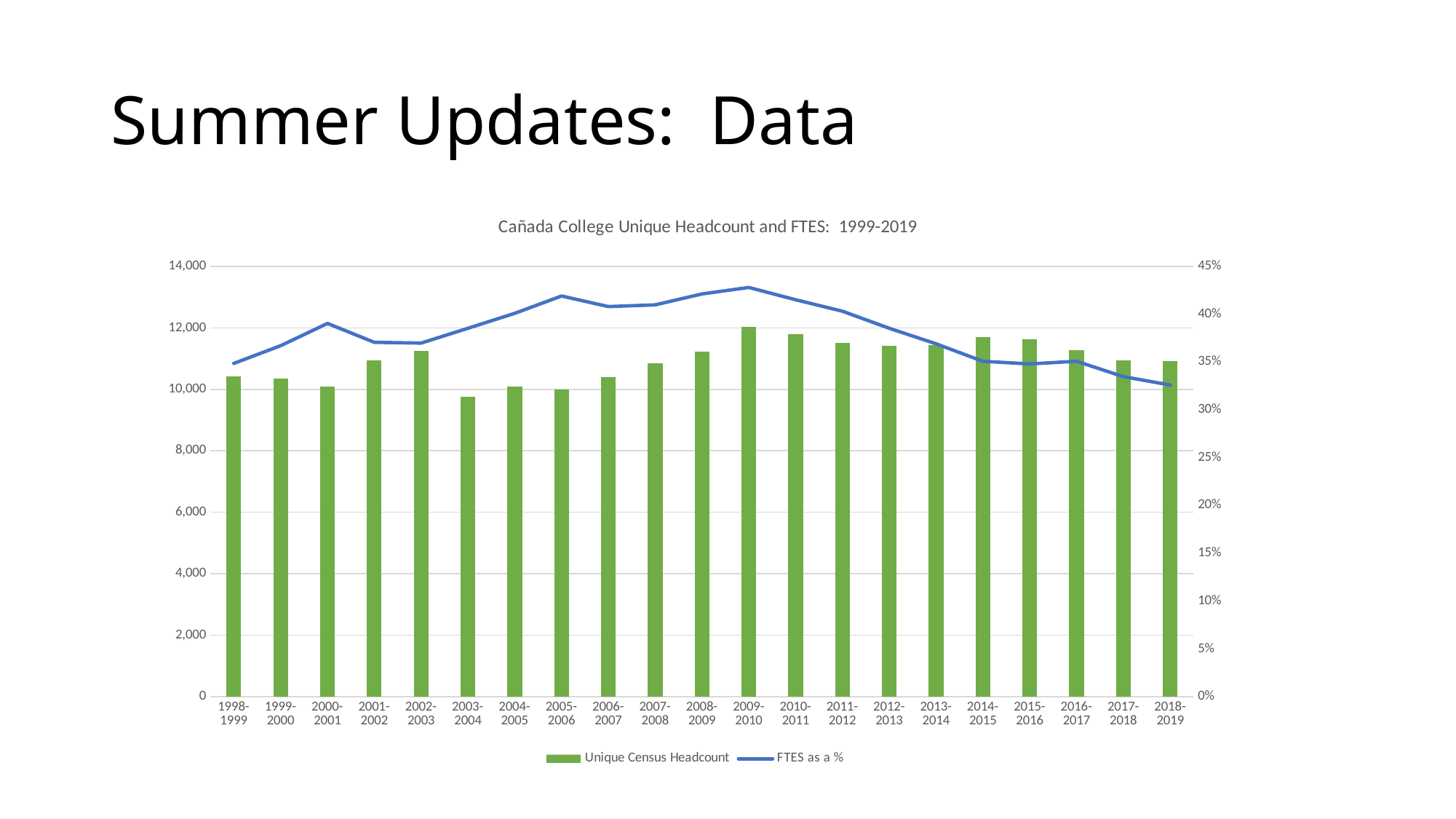
Does the FTES as a % line rise or fall from 2009-2010 to 2018-2019? fall What kind of chart is this? A combination bar and line chart What is the title of the chart? Cañada College Unique Headcount and FTES: 1999-2019 Which academic year has the highest Unique Census Headcount? 2009-2010 Which academic year has the lowest FTES as a %? 2018-2019 How many academic years are shown on the x axis? 21 Which has the larger Unique Census Headcount, 2000-2001 or 2002-2003? 2002-2003 Is the Unique Census Headcount for 2003-2004 greater or less than 10,000? less Is the FTES as a % for 2009-2010 greater or less than 40%? greater Which academic year has the lowest Unique Census Headcount? 2003-2004 How many series does the legend list? 2 Which academic year has the highest FTES as a %? 2009-2010